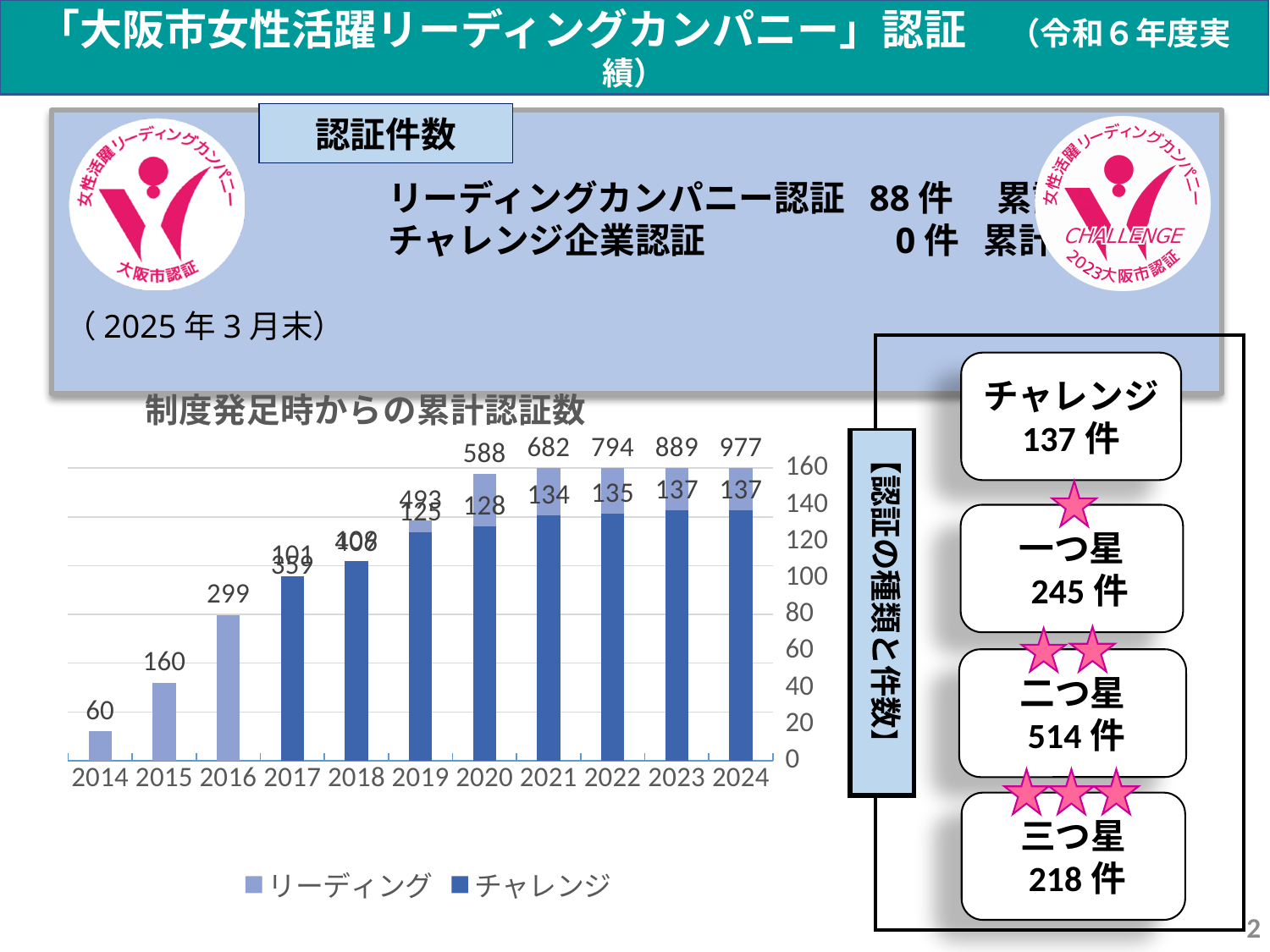
In the chart 制度発足時からの累計認証数, what is the difference between the リーディング values for 2024 and 2023? 88 In the chart 制度発足時からの累計認証数, what is the リーディング value for 2024? 977 In the chart 制度発足時からの累計認証数, which year has the highest リーディング value? 2024 How many series does the legend of the chart 制度発足時からの累計認証数 list? 2 In the chart 制度発足時からの累計認証数, what is the リーディング value for 2014? 60 In the chart 制度発足時からの累計認証数, which year has the lowest リーディング value? 2014 In the chart 制度発足時からの累計認証数, which is larger, the チャレンジ value for 2020 or for 2021? 2021 Do the リーディング values in the chart 制度発足時からの累計認証数 rise or fall from 2014 to 2024? rise In the chart 制度発足時からの累計認証数, what is the チャレンジ value for 2019? 125 In the chart 制度発足時からの累計認証数, what is the difference between the リーディング values for 2015 and 2014? 100 In the chart 制度発足時からの累計認証数, what is the チャレンジ value for 2021? 134 How many years are shown on the x axis of the chart 制度発足時からの累計認証数? 11